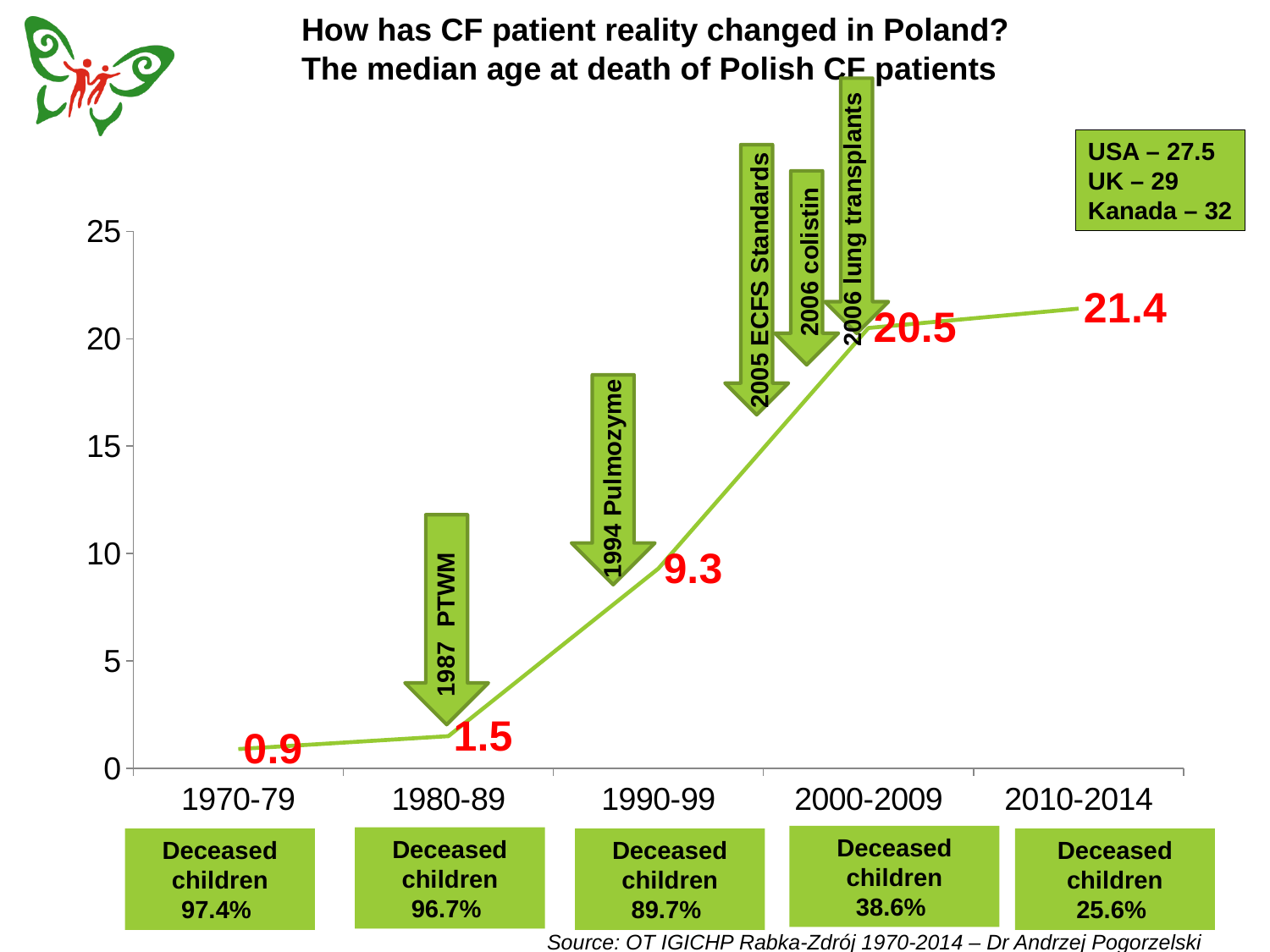
Does the median age at death rise or fall across the periods from 1970-79 to 2010-2014? rise What is the difference in median age at death between 2000-2009 and 1990-99? 11.2 What kind of chart is shown on the slide? line chart Which period has the lowest median age at death? 1970-79 What is the median age at death for the 1990-99 period? 9.3 How many time periods are plotted on the chart? 5 What is the difference in median age at death between 1980-89 and 1970-79? 0.6 What is the median age at death for the 1970-79 period? 0.9 What is the median age at death for the 2010-2014 period? 21.4 Which period has the highest median age at death? 2010-2014 Which period has a higher median age at death, 1990-99 or 2000-2009? 2000-2009 Is the median age at death for 2000-2009 greater or less than 20? greater